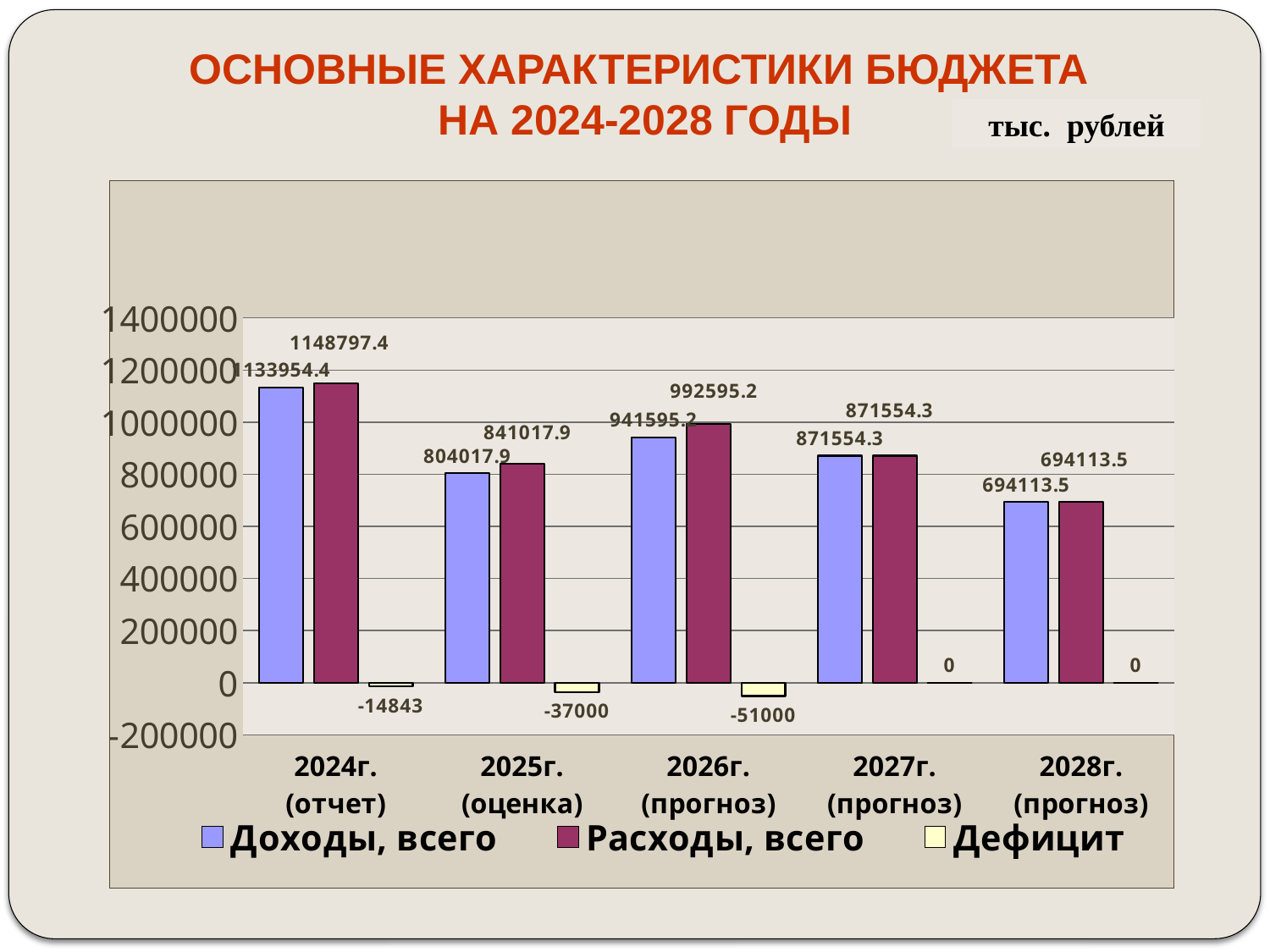
What is the value of Дефицит for 2026г. (прогноз)? -51000 How many series does the legend list? 3 Which year has the highest value of Расходы, всего? 2024г. (отчет) Which year has the lowest value of Доходы, всего? 2028г. (прогноз) What type of chart is shown on the slide? bar chart What is the value of Расходы, всего for 2024г. (отчет)? 1148797.4 What is the value of Расходы, всего for 2028г. (прогноз)? 694113.5 What is the difference between Расходы, всего and Доходы, всего for 2025г. (оценка)? 37000 Which is larger for 2026г. (прогноз): Доходы, всего or Расходы, всего? Расходы, всего Is the value of Доходы, всего for 2024г. (отчет) greater or less than 1000000? greater How many year categories are shown on the x axis? 5 What is the value of Доходы, всего for 2025г. (оценка)? 804017.9